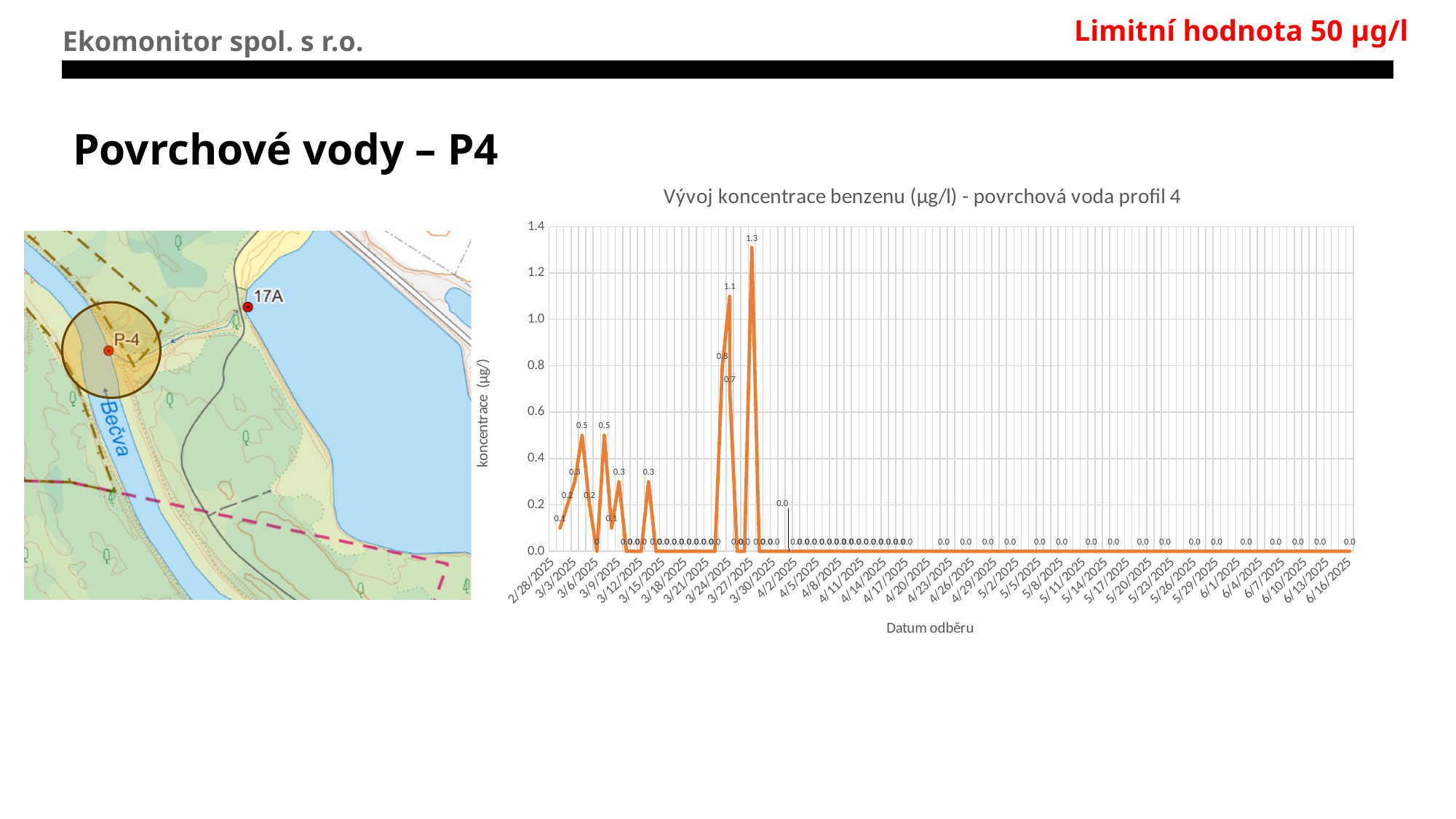
Is the highest peak on the chart greater or less than 1.0? greater What kind of chart is shown on the slide? line chart After the peak of 1.3 at the end of March, do the values rise or fall for the rest of the period? fall What is the concentration value at the first date, 2/28/2025? 0.1 What is the lowest value labelled on the chart? 0.0 What is the concentration value at the last date, 6/16/2025? 0.0 What is the title of the chart? Vývoj koncentrace benzenu (µg/l) - povrchová voda profil 4 What is the label of the x axis of the chart? Datum odběru How many labelled peaks on the chart exceed 1.0? 2 What is the difference between the highest peak (1.3) and the second-highest peak (1.1)? 0.2 What is the highest benzene concentration value labelled on the chart? 1.3 Is the value at 2/28/2025 greater or less than 0.2? less